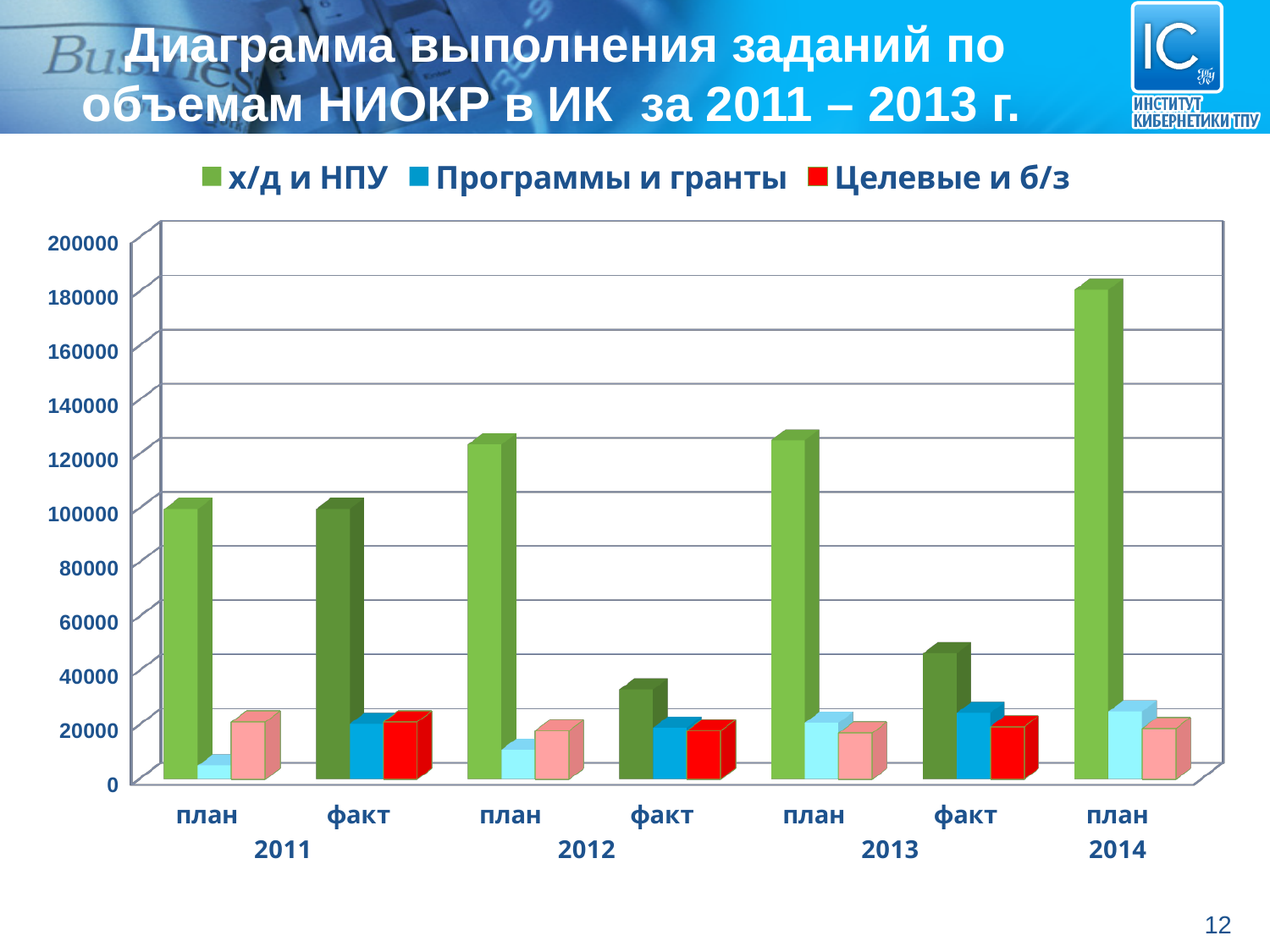
For the series х/д и НПУ, which category has the lowest value? факт 2012 How many series does the legend list? 3 Is the value of Программы и гранты for план 2011 greater or less than 20000? less Is the value of х/д и НПУ for план 2012 greater or less than 100000? greater Is the value of х/д и НПУ for план 2014 greater or less than 160000? greater What kind of chart is shown on the slide? bar chart Which colour represents the series Целевые и б/з in the legend? red How many categories (план/факт groups) are shown along the x axis? 7 For х/д и НПУ in 2012, which is larger: план or факт? план For Программы и гранты in 2011, which is larger: план or факт? факт For the series х/д и НПУ, which category has the highest value? план 2014